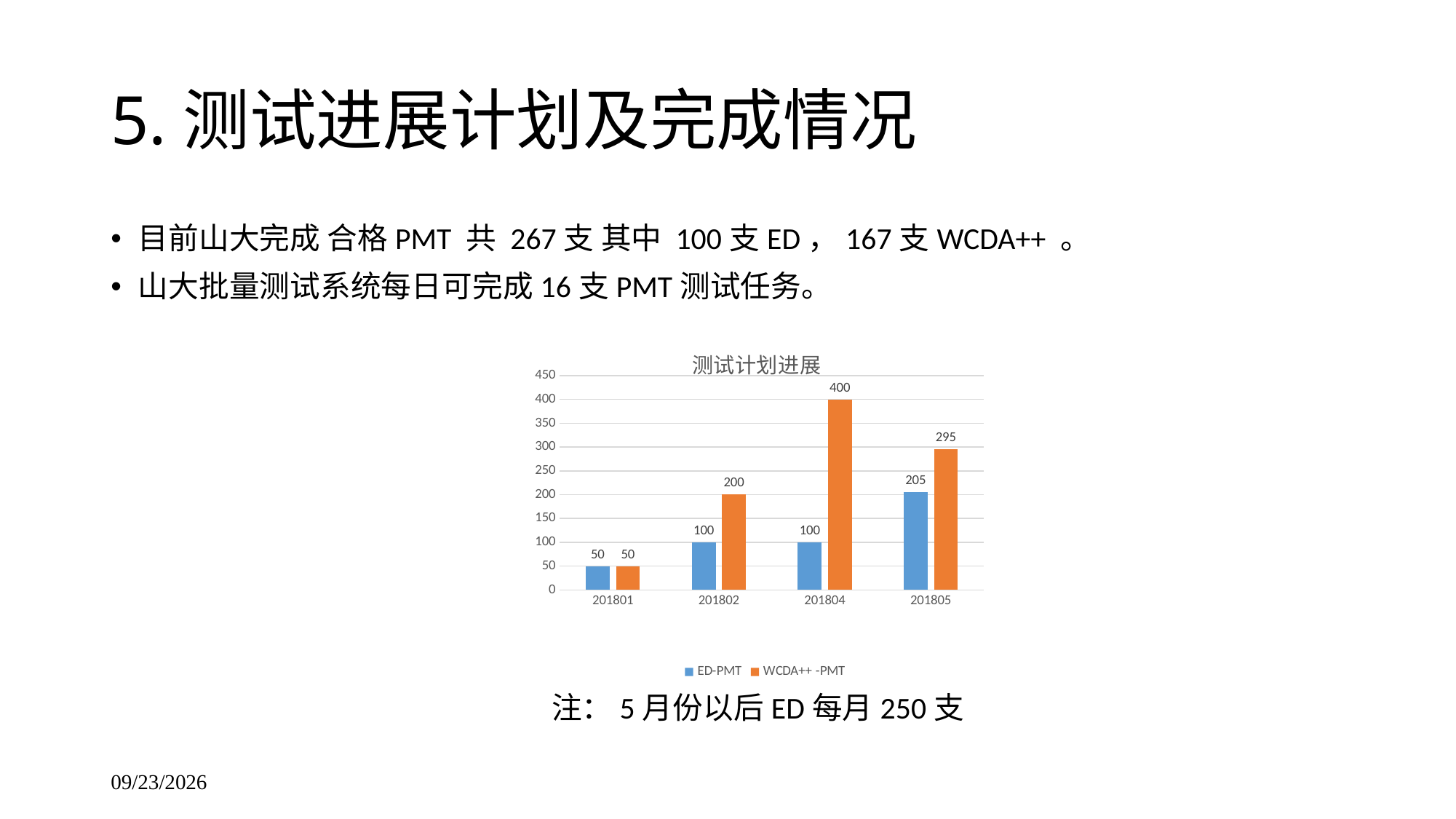
What is the title of the chart? 测试计划进展 How many categories are shown on the x axis? 4 Which category has the lowest ED-PMT value? 201801 What kind of chart is shown on the slide? Bar chart What is the value of WCDA++ -PMT for 201804? 400 How many series does the legend list? 2 Does the WCDA++ -PMT value rise or fall from 201801 to 201804? Rise What is the difference between the WCDA++ -PMT and ED-PMT values for 201805? 90 Which is larger for 201802: ED-PMT or WCDA++ -PMT? WCDA++ -PMT What is the value of WCDA++ -PMT for 201802? 200 Which category has the highest WCDA++ -PMT value? 201804 What is the value of ED-PMT for 201805? 205